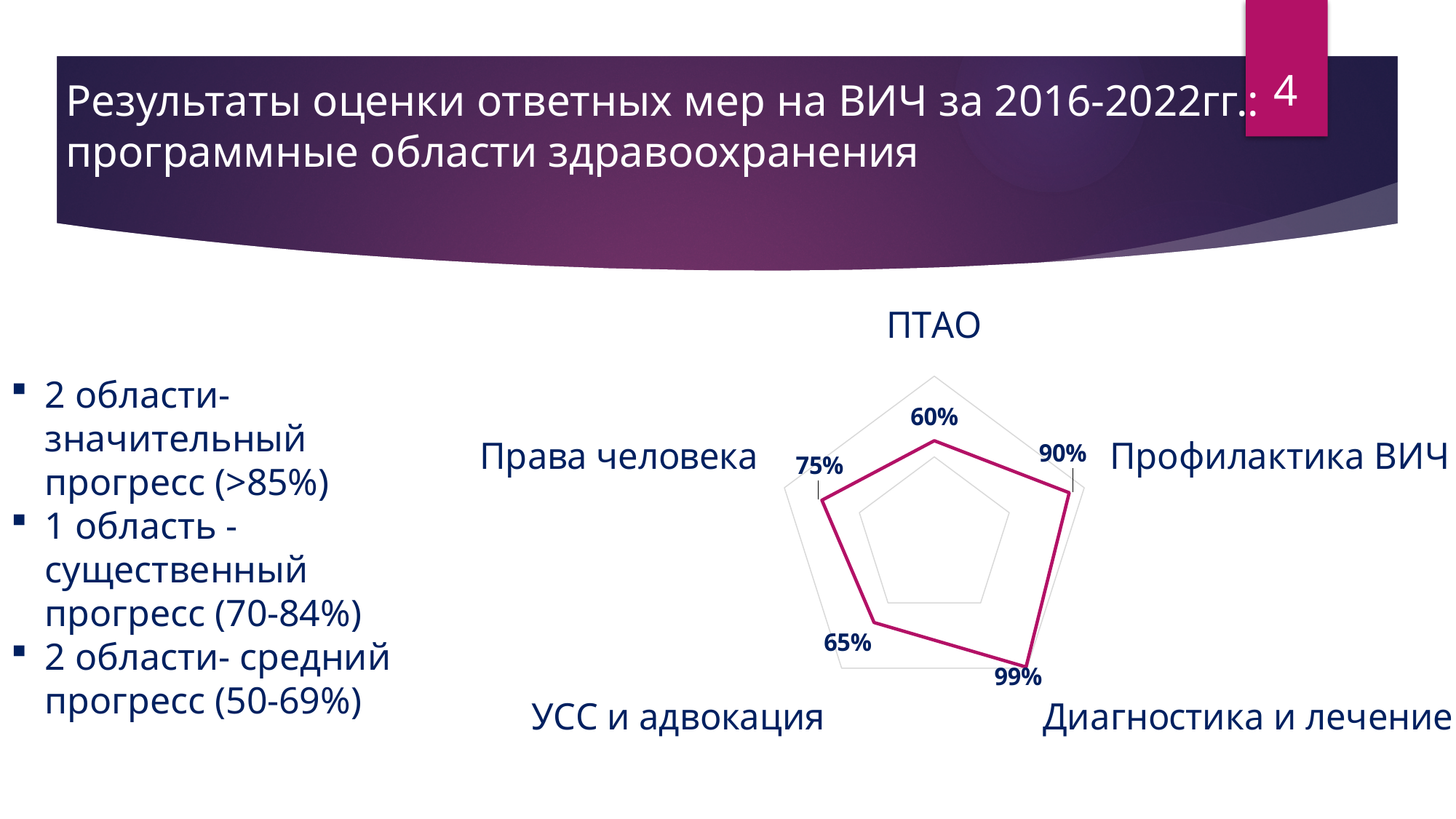
What kind of chart is shown on the slide? Radar chart What is the value for Диагностика и лечение? 99% Which category has the highest value? Диагностика и лечение Which is larger, the value for Права человека or the value for УСС и адвокация? Права человека What is the value for Профилактика ВИЧ? 90% What is the value for УСС и адвокация? 65% What is the difference between the values for Диагностика и лечение and ПТАО? 39% How many categories does the chart show? 5 What is the value for ПТАО? 60% What is the difference between the values for Профилактика ВИЧ and Права человека? 15% Which category has the lowest value? ПТАО What is the value for Права человека? 75%